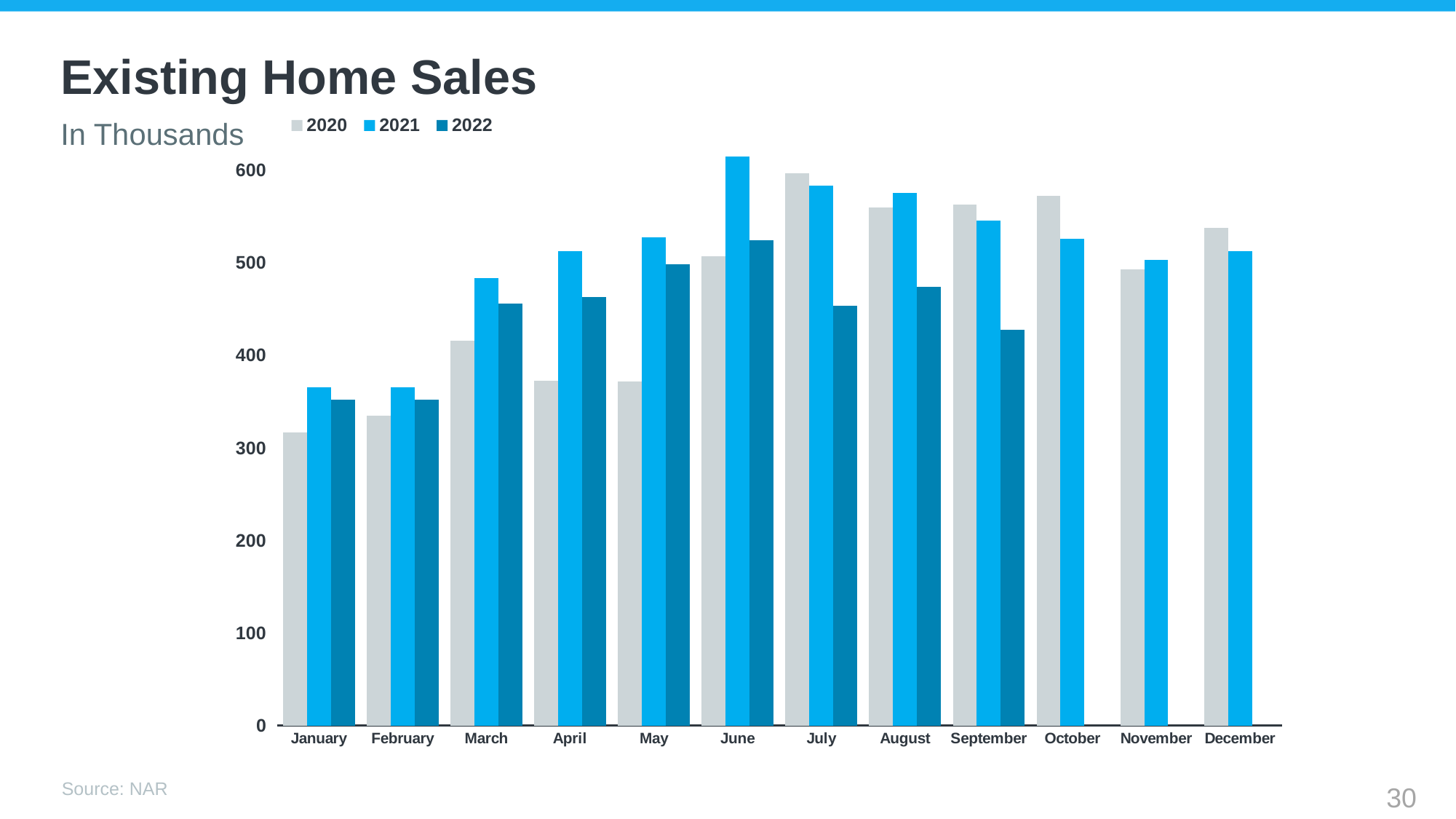
Which series has no bars for October, November and December? 2022 In which month is the 2020 value lowest? January Is the 2022 value for September greater or less than 500? less Which is larger for March: the 2020 value or the 2021 value? 2021 What kind of chart is shown on the slide? Bar chart Is the 2020 value for January greater or less than 400? less How many series does the legend list? 3 How many months are shown along the x axis? 12 Is the 2021 value for June greater or less than 600? greater In which month is the 2021 value highest? June Which is larger for July: the 2020 value or the 2022 value? 2020 In which month is the 2022 value highest? June